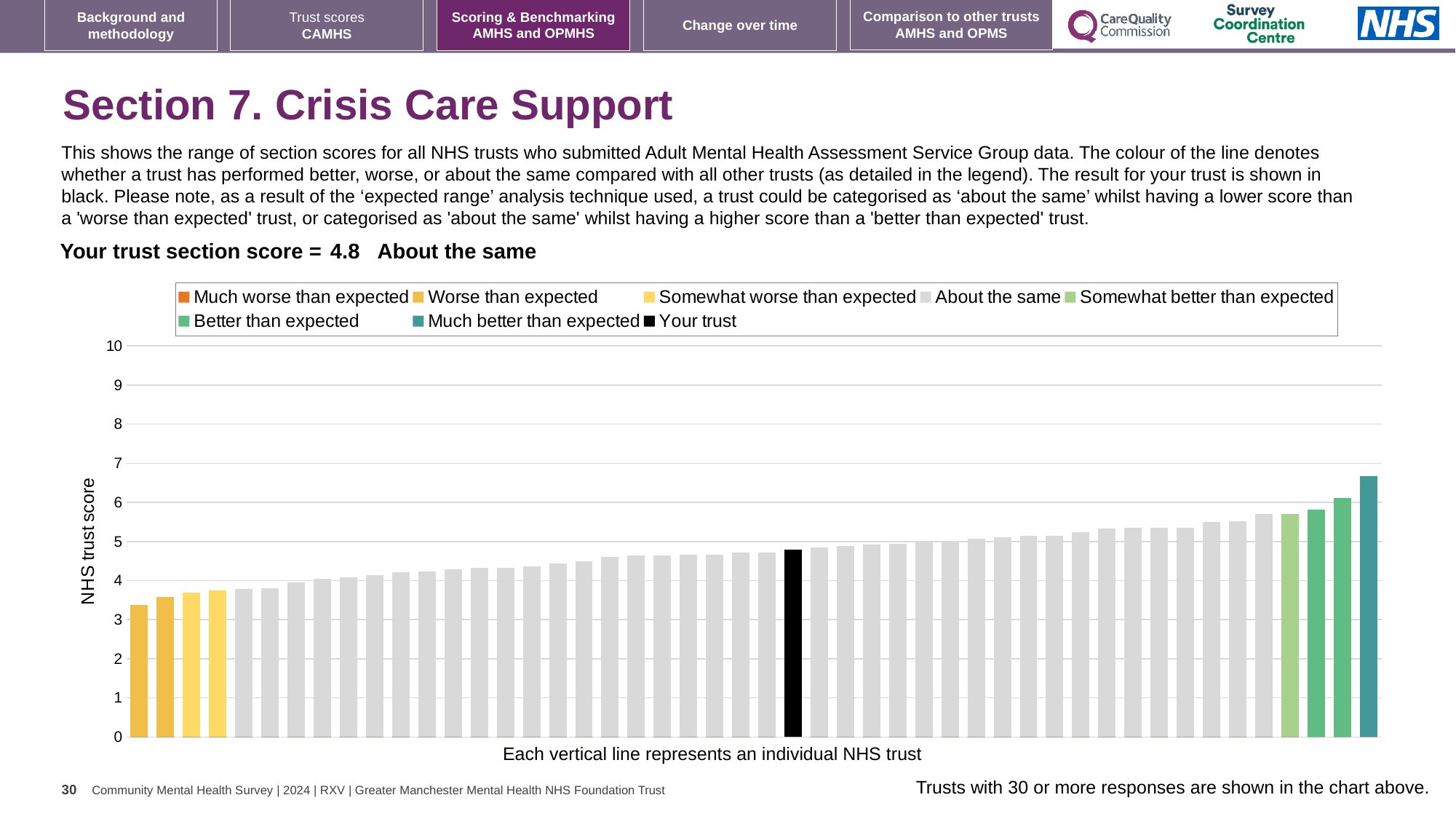
Is the value of the black 'Your trust' bar greater or less than 5? less What is the title of the vertical axis of the chart? NHS trust score How many entries does the chart legend list? 8 Is the value of the tallest bar in the chart greater or less than 6? greater Is the value of the shortest bar in the chart greater or less than 4? less What is the section score for your trust shown on the slide? 4.8 Which is larger: the rightmost bar or the black 'Your trust' bar? the rightmost bar Which benchmarking category is your trust placed in for this section? About the same How many bars are coloured as 'Much better than expected'? 1 What kind of chart is shown on the slide? bar chart Do the bar values rise or fall moving from left to right along the x axis? rise How many bars are coloured as 'Better than expected'? 2